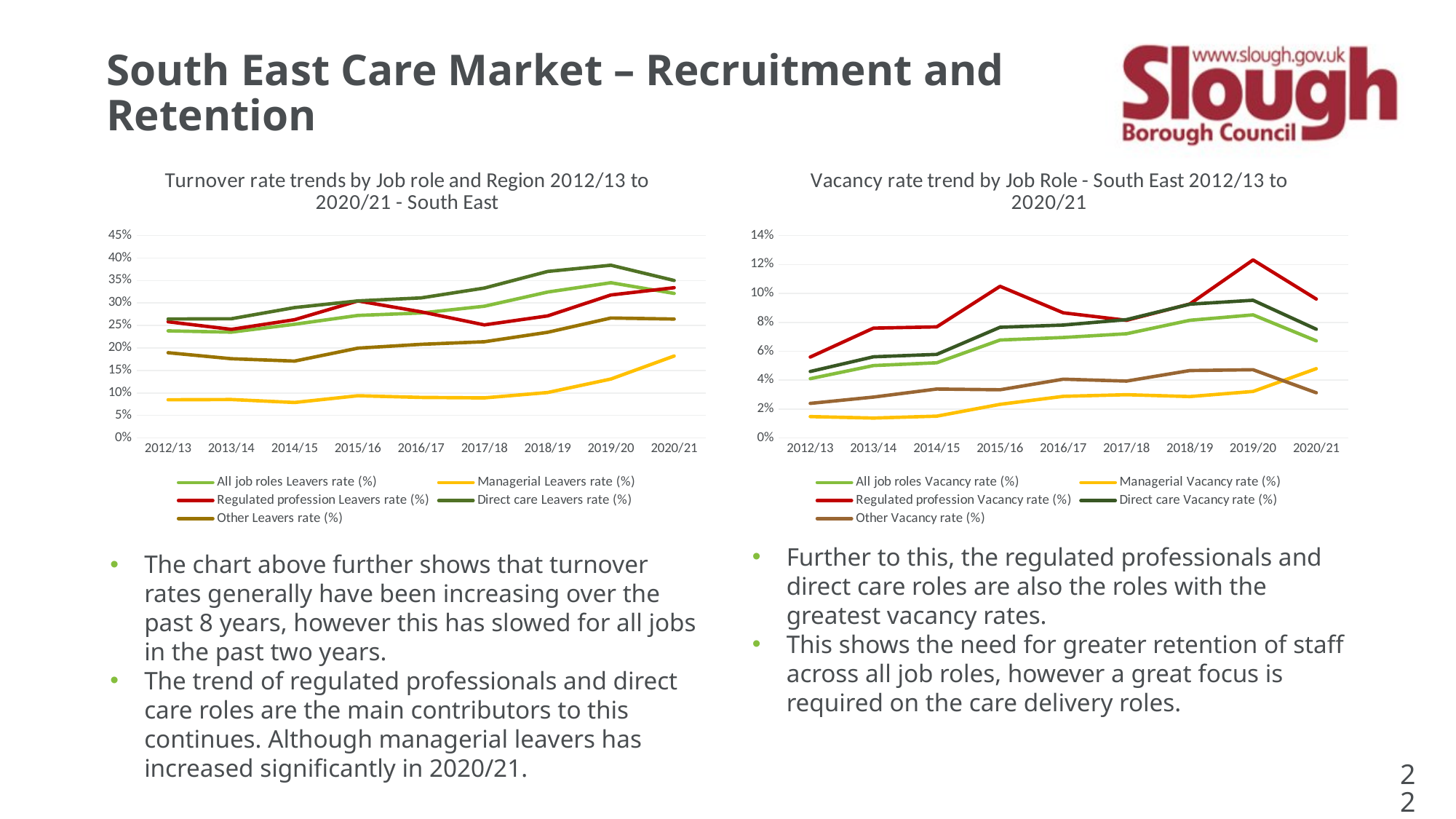
How many series does the legend of the 'Vacancy rate trend by Job Role - South East 2012/13 to 2020/21' chart list? 5 In the 'Vacancy rate trend by Job Role - South East' chart, is the Managerial Vacancy rate in 2012/13 greater or less than 2%? less In the 'Turnover rate trends by Job role and Region' chart, does the Managerial Leavers rate rise or fall between 2017/18 and 2020/21? rise In the 'Turnover rate trends by Job role and Region' chart, which series has the highest value in 2019/20? Direct care Leavers rate (%) How many years are shown on the x axis of the 'Turnover rate trends by Job role and Region' chart? 9 In the 'Vacancy rate trend by Job Role - South East' chart, is the Regulated profession Vacancy rate in 2019/20 greater or less than 10%? greater In the 'Turnover rate trends by Job role and Region' chart, which series has the lowest value in 2012/13? Managerial Leavers rate (%) In the 'Vacancy rate trend by Job Role - South East' chart, which series has the highest value in 2019/20? Regulated profession Vacancy rate (%) What kind of chart is the 'Turnover rate trends by Job role and Region 2012/13 to 2020/21 - South East' chart? Line chart In the 'Vacancy rate trend by Job Role - South East' chart, which is larger in 2020/21: the Managerial Vacancy rate or the Other Vacancy rate? Managerial Vacancy rate (%) In the 'Turnover rate trends by Job role and Region' chart, is the Managerial Leavers rate in 2012/13 greater or less than 10%? less